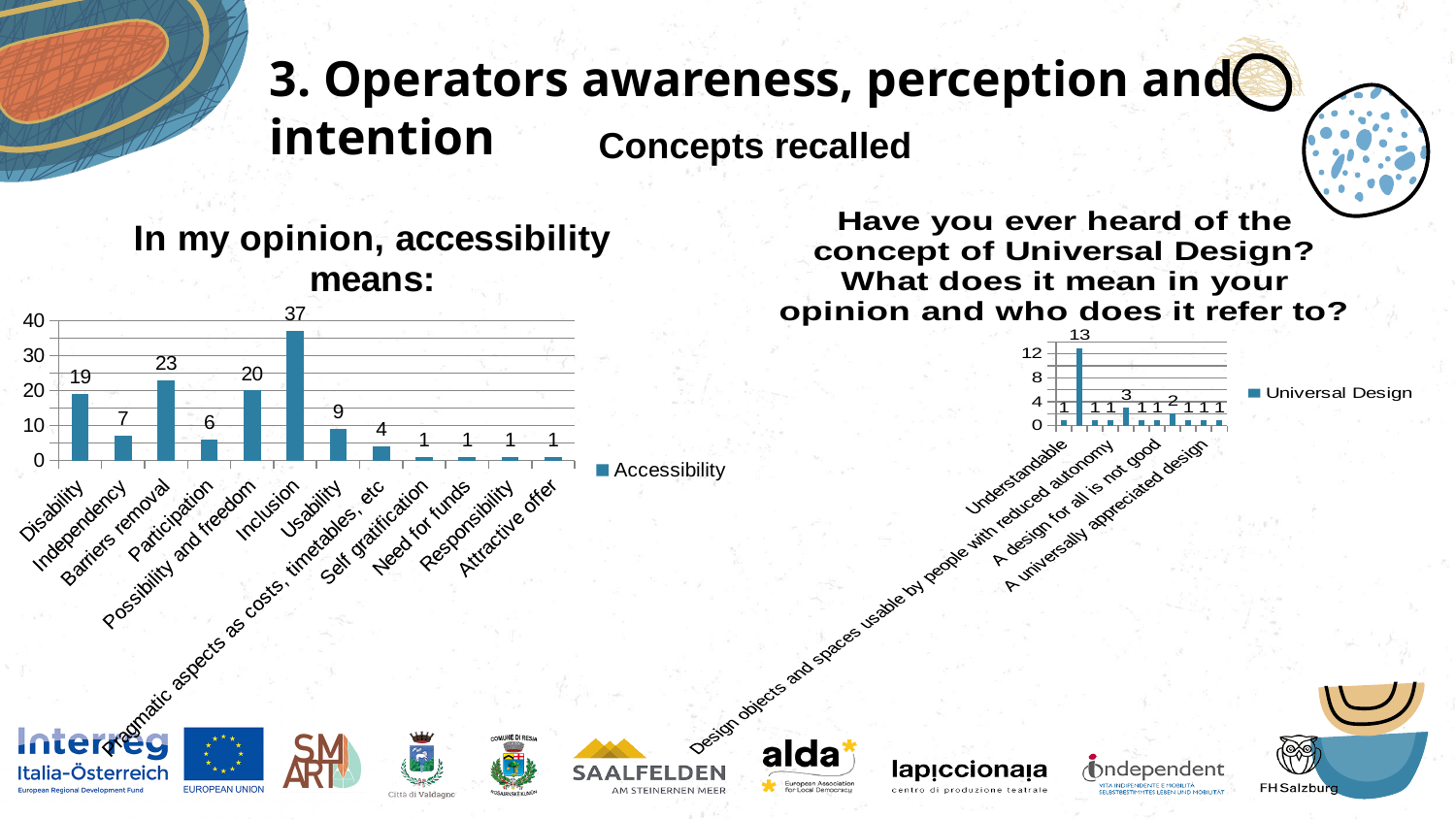
What kind of chart is 'In my opinion, accessibility means:'? bar chart In the chart on the right about Universal Design, what is the legend entry? Universal Design In the chart 'In my opinion, accessibility means:', what is the value for Barriers removal? 23 In the chart 'In my opinion, accessibility means:', what is the value for Participation? 6 In the chart 'In my opinion, accessibility means:', which category has the highest value? Inclusion In the chart 'In my opinion, accessibility means:', what is the difference between the values for Inclusion and Barriers removal? 14 In the chart on the right about Universal Design, what is the highest value shown on any bar? 13 In the chart 'In my opinion, accessibility means:', which is larger, the value for Possibility and freedom or the value for Disability? Possibility and freedom In the chart 'In my opinion, accessibility means:', is the value for Usability greater or less than 10? less In the chart 'In my opinion, accessibility means:', how many categories are shown on the x axis? 12 In the chart 'In my opinion, accessibility means:', what is the legend entry? Accessibility In the chart 'In my opinion, accessibility means:', what is the value for Inclusion? 37